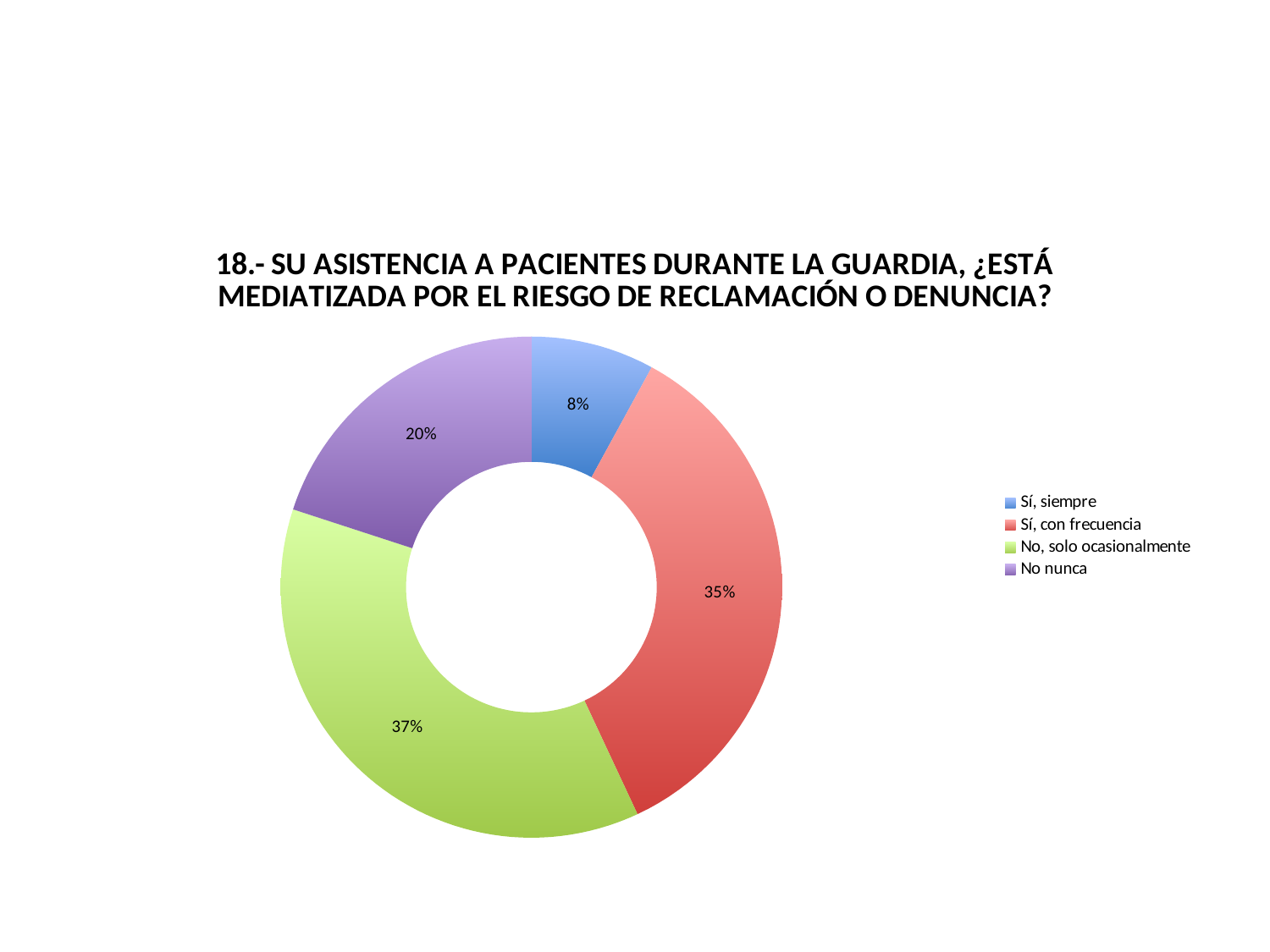
Which is larger, the share for "No nunca" or the share for "Sí, siempre"? No nunca How many response categories does the chart show? 4 Which response category has the largest share? No, solo ocasionalmente Which response category has the smallest share? Sí, siempre What percentage of respondents answered "No nunca"? 20% What percentage of respondents answered "No, solo ocasionalmente"? 37% What percentage of respondents answered "Sí, con frecuencia"? 35% What kind of chart is shown on the slide? Doughnut chart What percentage of respondents answered "Sí, siempre"? 8% What colour represents "Sí, con frecuencia" in the chart? Red What is the difference in percentage points between "No, solo ocasionalmente" and "Sí, siempre"? 29 What is the difference in percentage points between "Sí, con frecuencia" and "No nunca"? 15